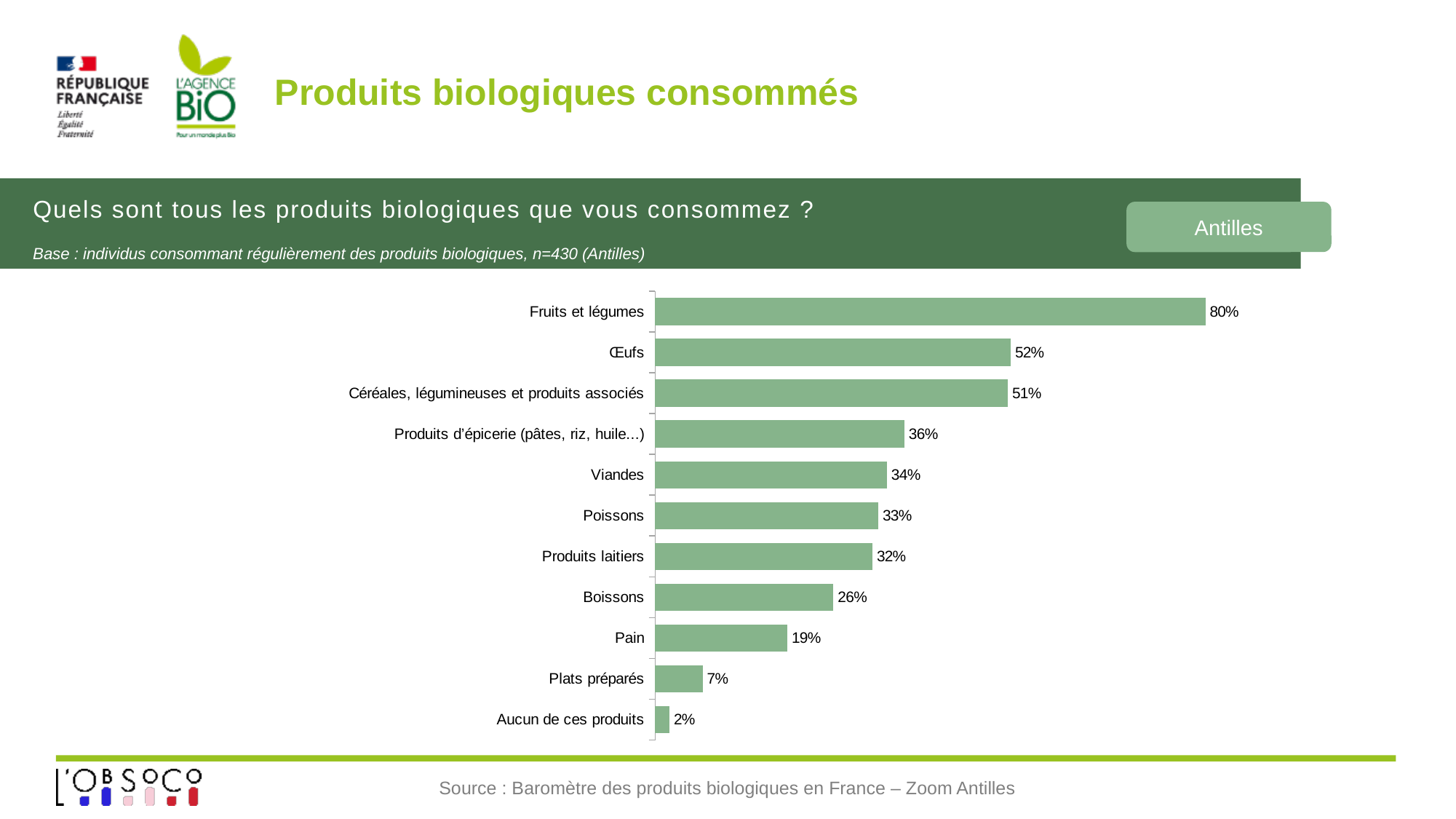
What kind of chart is shown on the slide? Bar chart What is the value shown for 'Œufs'? 52% What is the value for 'Aucun de ces produits'? 2% Which category has the lowest value on the chart? Aucun de ces produits What percentage is shown for 'Pain'? 19% Which is larger, the value for 'Boissons' or the value for 'Pain'? Boissons What percentage of respondents consume organic 'Fruits et légumes'? 80% What is the difference between the values for 'Fruits et légumes' and 'Œufs'? 28 percentage points How many categories are shown on the chart? 11 What is the difference between the values for 'Produits d'épicerie (pâtes, riz, huile...)' and 'Plats préparés'? 29 percentage points What region is indicated in the label box at the top right of the chart area? Antilles Which category has the highest value on the chart? Fruits et légumes